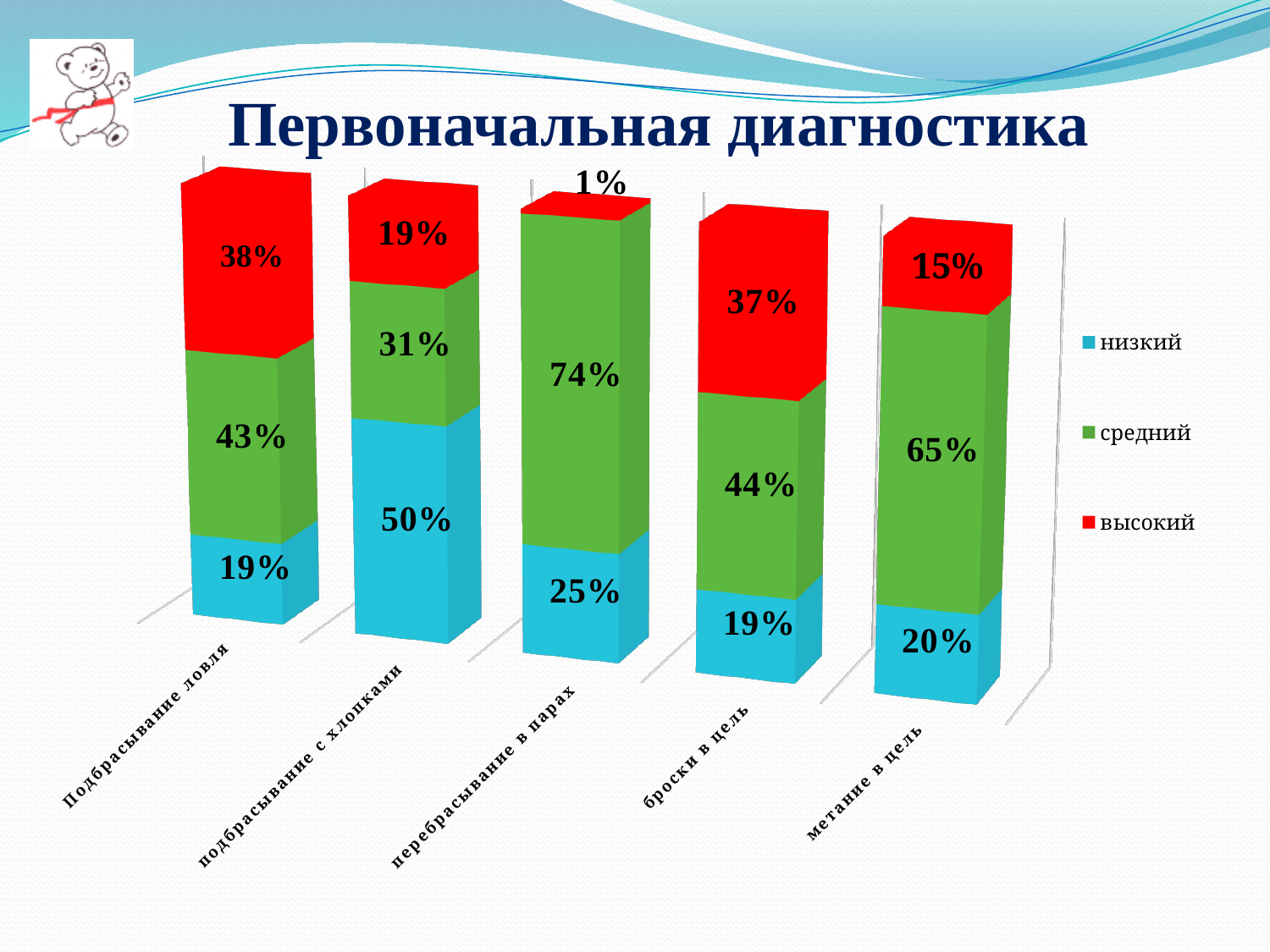
What is the value of the 'средний' series for 'перебрасывание в парах'? 74% What kind of chart is shown on the slide? Stacked bar chart What is the value of the 'высокий' series for 'метание в цель'? 15% What is the total of the stacked bar for 'броски в цель'? 100% Which category has the lowest value for the 'высокий' series? перебрасывание в парах How many categories are shown on the x axis? 5 What is the value of the 'низкий' series for 'подбрасывание с хлопками'? 50% What is the difference between the 'средний' values for 'перебрасывание в парах' and 'метание в цель'? 9% Which category has the highest value for the 'высокий' series? Подбрасывание ловля What is the value of the 'высокий' series for 'Подбрасывание ловля'? 38% How many series does the legend list? 3 Which is larger: the 'низкий' value for 'подбрасывание с хлопками' or the 'низкий' value for 'перебрасывание в парах'? подбрасывание с хлопками